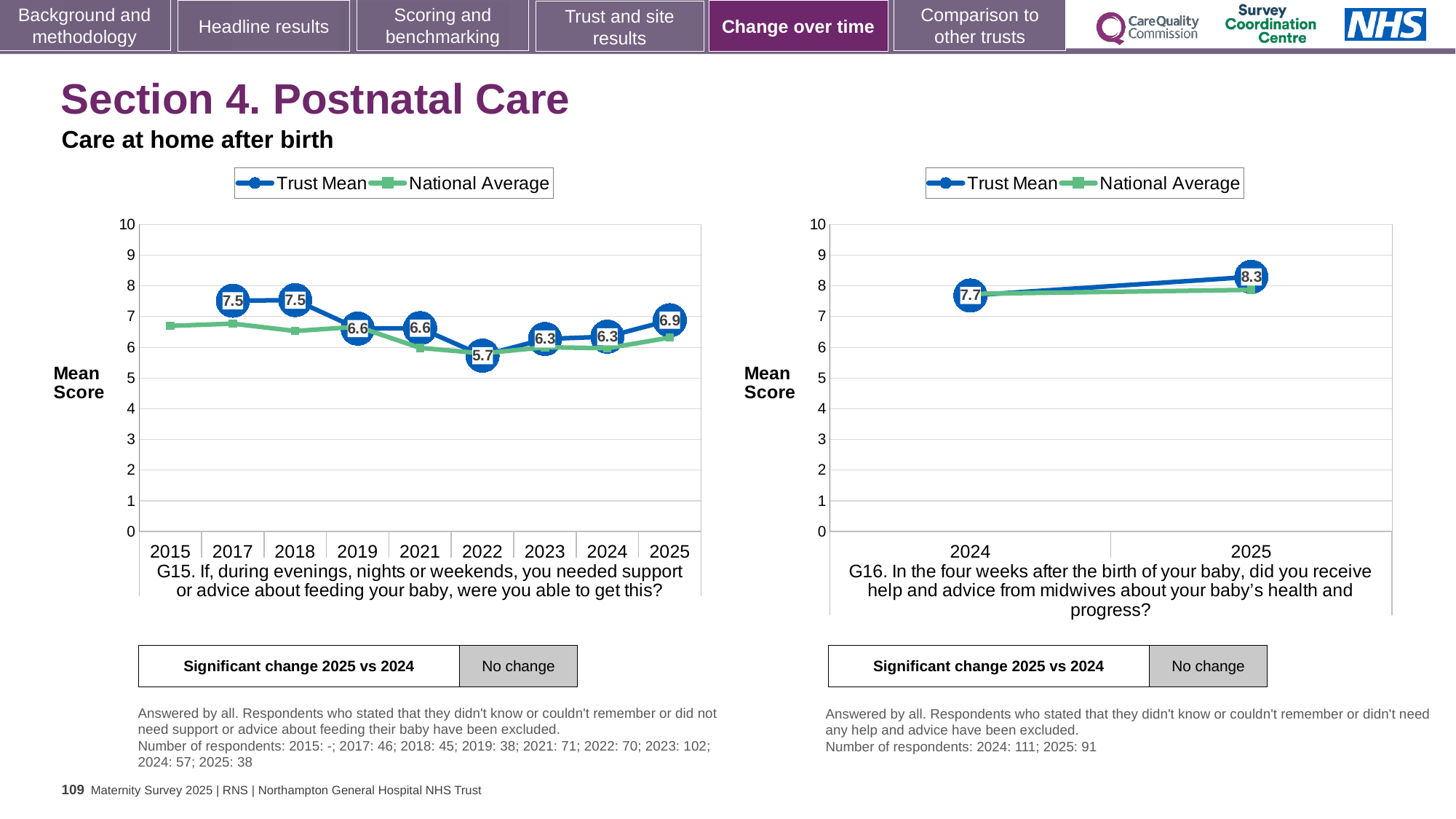
On the G15 chart (left), is the Trust Mean score higher in 2018 or in 2019? 2018 On the G16 chart (right), does the Trust Mean rise or fall from 2024 to 2025? rise On the G15 chart (left), which year has the lowest Trust Mean score? 2022 On the G16 chart (right), what is the Trust Mean score for 2025? 8.3 On the G15 chart (left), is the National Average value for 2015 greater or less than 6? greater On the G15 chart (left), what is the difference between the Trust Mean scores for 2025 and 2024? 0.6 On the G15 chart (left), what is the Trust Mean score for 2022? 5.7 How many series does the legend of the G16 chart (right) list? 2 On the G16 chart (right), what is the Trust Mean score for 2024? 7.7 On the G15 chart (left), how many years are shown on the x axis? 9 On the G16 chart (right), by how much did the Trust Mean score change from 2024 to 2025? 0.6 On the G15 chart (left), what is the Trust Mean score for 2025? 6.9